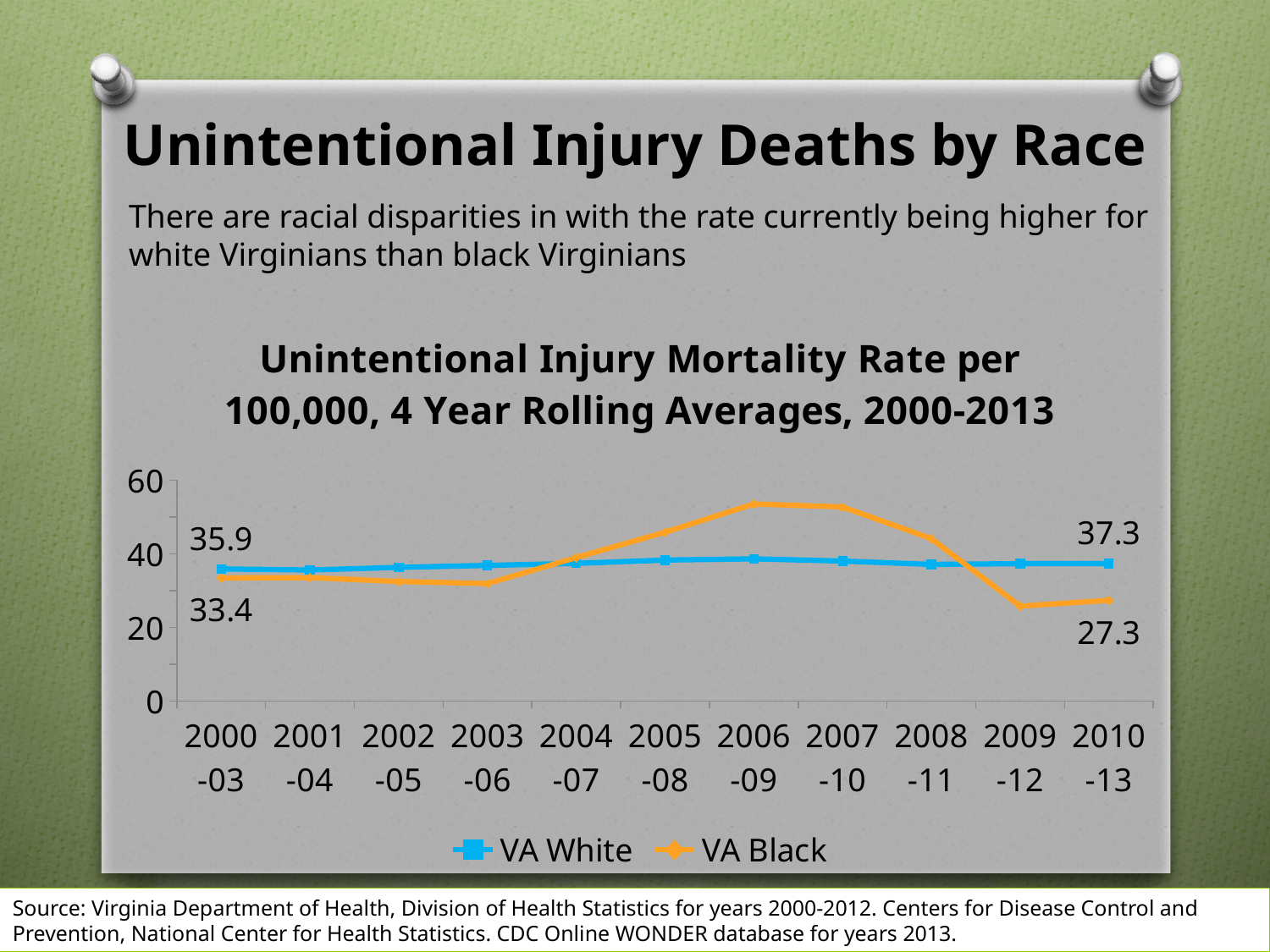
What is the difference between the VA White and VA Black values for 2010-13? 10 How many series does the legend list? 2 What is the VA Black value for 2000-03? 33.4 Which series has the larger value for 2010-13, VA White or VA Black? VA White What type of chart is shown on the slide? line chart How many time periods are shown on the x axis? 11 What is the difference between the VA White values for 2010-13 and 2000-03? 1.4 Is the VA Black value for 2006-09 greater or less than 40? greater What is the VA White value for 2010-13? 37.3 What is the VA White value for 2000-03? 35.9 What is the VA Black value for 2010-13? 27.3 What is the title of the chart? Unintentional Injury Mortality Rate per 100,000, 4 Year Rolling Averages, 2000-2013